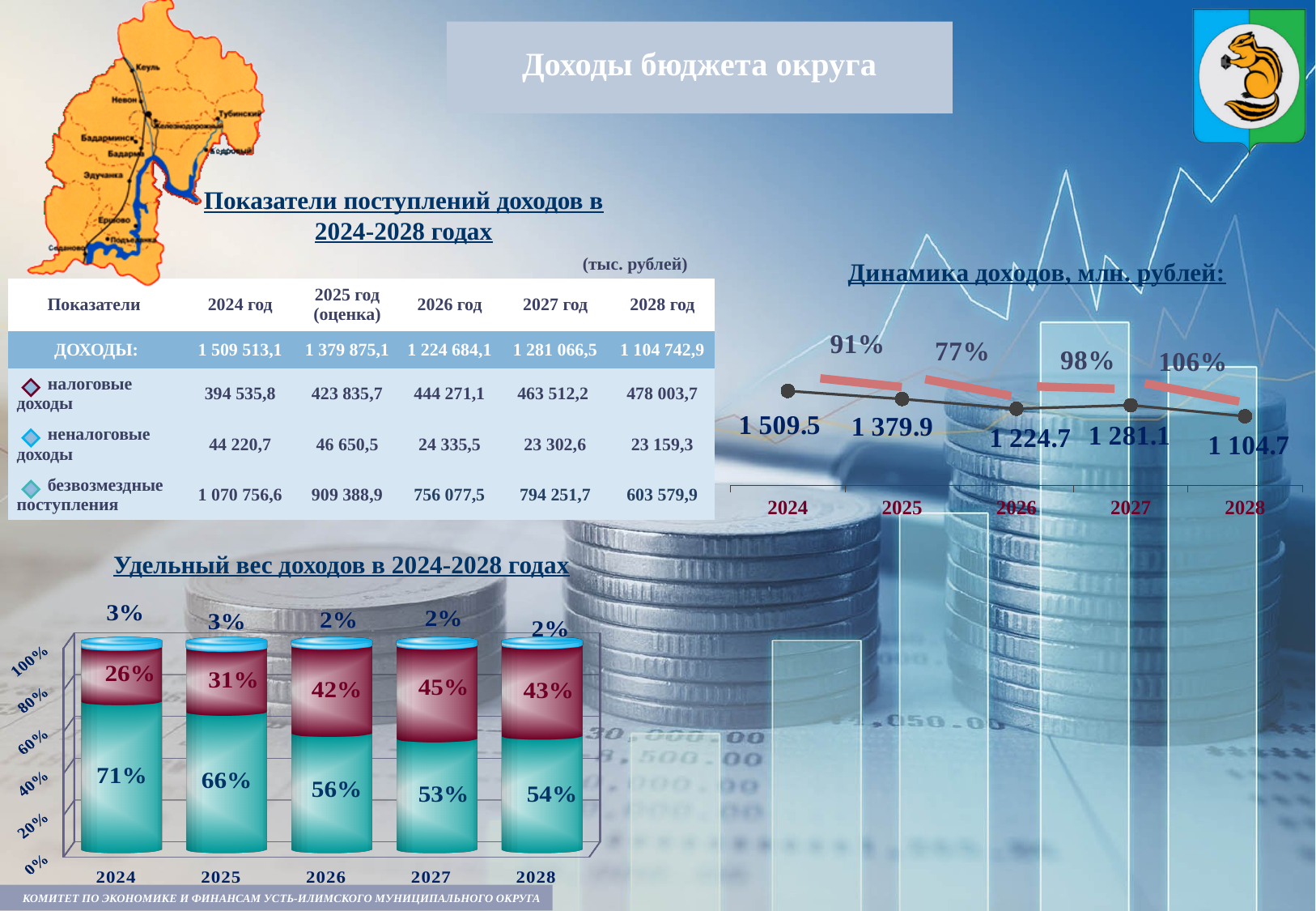
What kind of chart is 'Динамика доходов, млн. рублей'? line chart In the chart 'Динамика доходов, млн. рублей', what percentage is shown above the line between 2027 and 2028? 106% In the chart 'Удельный вес доходов в 2024-2028 годах', which year has the highest red (middle) segment value? 2027 In the chart 'Удельный вес доходов в 2024-2028 годах', what is the value of the red (middle) segment for 2027? 45% How many years are plotted in the chart 'Динамика доходов, млн. рублей'? 5 In the chart 'Удельный вес доходов в 2024-2028 годах', what is the difference between the teal segment values for 2024 and 2028? 17% In the chart 'Динамика доходов, млн. рублей', which year has the highest value? 2024 In the chart 'Динамика доходов, млн. рублей', what is the value for 2024? 1 509.5 In the chart 'Динамика доходов, млн. рублей', which is larger: the value for 2026 or the value for 2027? 2027 In the chart 'Динамика доходов, млн. рублей', what is the value for 2028? 1 104.7 In the chart 'Динамика доходов, млн. рублей', which year has the lowest value? 2028 In the chart 'Удельный вес доходов в 2024-2028 годах', what is the value of the teal (bottom) segment for 2024? 71%